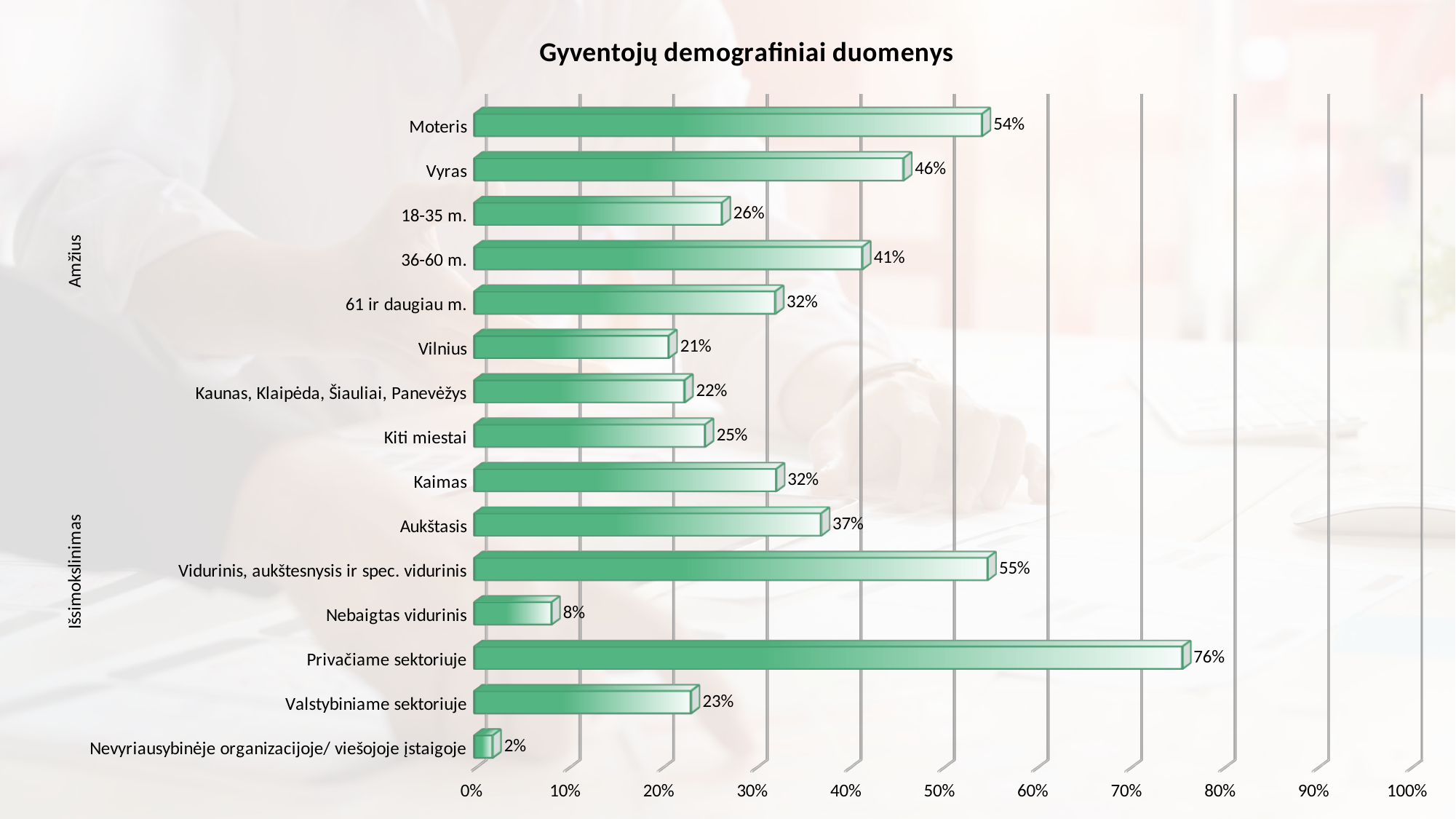
What is the title of the chart? Gyventojų demografiniai duomenys What is the value for Moteris? 54% Which is larger, the value for 36-60 m. or the value for 18-35 m.? 36-60 m. What is the difference between the values for Moteris and Vyras? 8% Which category has the highest value? Privačiame sektoriuje How many categories are shown in the chart? 15 What kind of chart is shown on the slide? bar chart Which category has the lowest value? Nevyriausybinėje organizacijoje/ viešojoje įstaigoje What is the value for Nebaigtas vidurinis? 8% What is the difference between the values for Vidurinis, aukštesnysis ir spec. vidurinis and Aukštasis? 18% What is the value for Privačiame sektoriuje? 76% Is the value for Aukštasis greater or less than 30%? greater